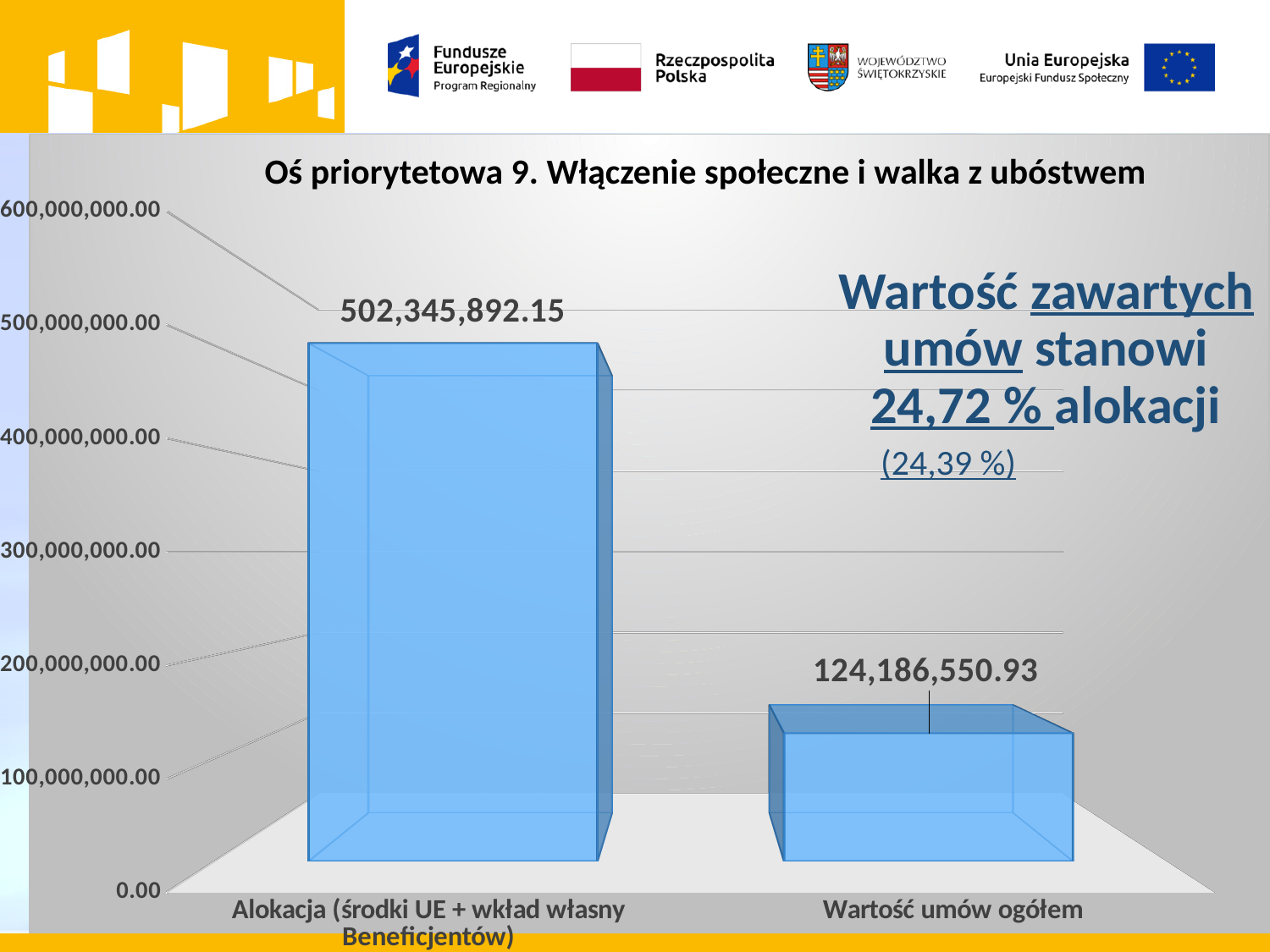
Which category has the highest value? Alokacja (środki UE + wkład własny Beneficjentów) What is the title of the chart? Oś priorytetowa 9. Włączenie społeczne i walka z ubóstwem Which is larger: the value for Alokacja (środki UE + wkład własny Beneficjentów) or the value for Wartość umów ogółem? Alokacja (środki UE + wkład własny Beneficjentów) Which category has the lowest value? Wartość umów ogółem Is the value for Alokacja (środki UE + wkład własny Beneficjentów) greater or less than 400,000,000.00? greater How many categories are shown on the chart? 2 What is the value for Alokacja (środki UE + wkład własny Beneficjentów)? 502,345,892.15 What is the value for Wartość umów ogółem? 124,186,550.93 Is the value for Wartość umów ogółem greater or less than 200,000,000.00? less According to the text on the slide, what percentage of the allocation does the value of concluded contracts represent? 24,72 % What is the difference between the value for Alokacja (środki UE + wkład własny Beneficjentów) and the value for Wartość umów ogółem? 378,159,341.22 What kind of chart is shown on the slide? bar chart